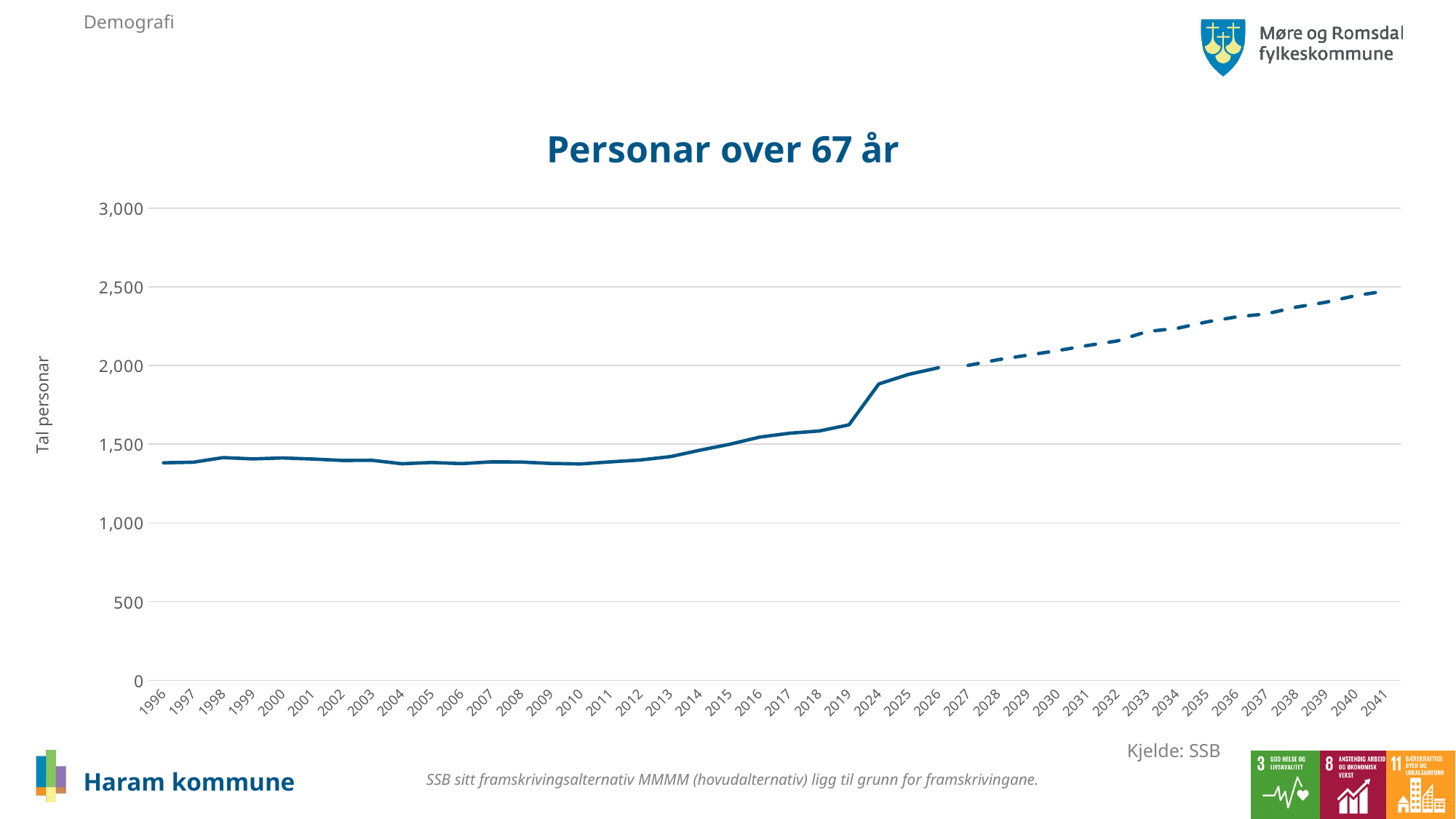
Is the value for 2024 greater or less than 1,500? greater Is the value for 2010 greater or less than 1,500? less Which year has the highest value on the chart? 2041 Is the value for 2041 greater or less than 2,000? greater How many years are shown on the x axis of the chart? 42 Which is larger, the value for 2041 or the value for 1996? 2041 What kind of chart is shown on the slide? line chart What is the title of the chart? Personar over 67 år What is the label on the vertical axis of the chart? Tal personar Do the values generally rise or fall from 2012 to 2041? rise